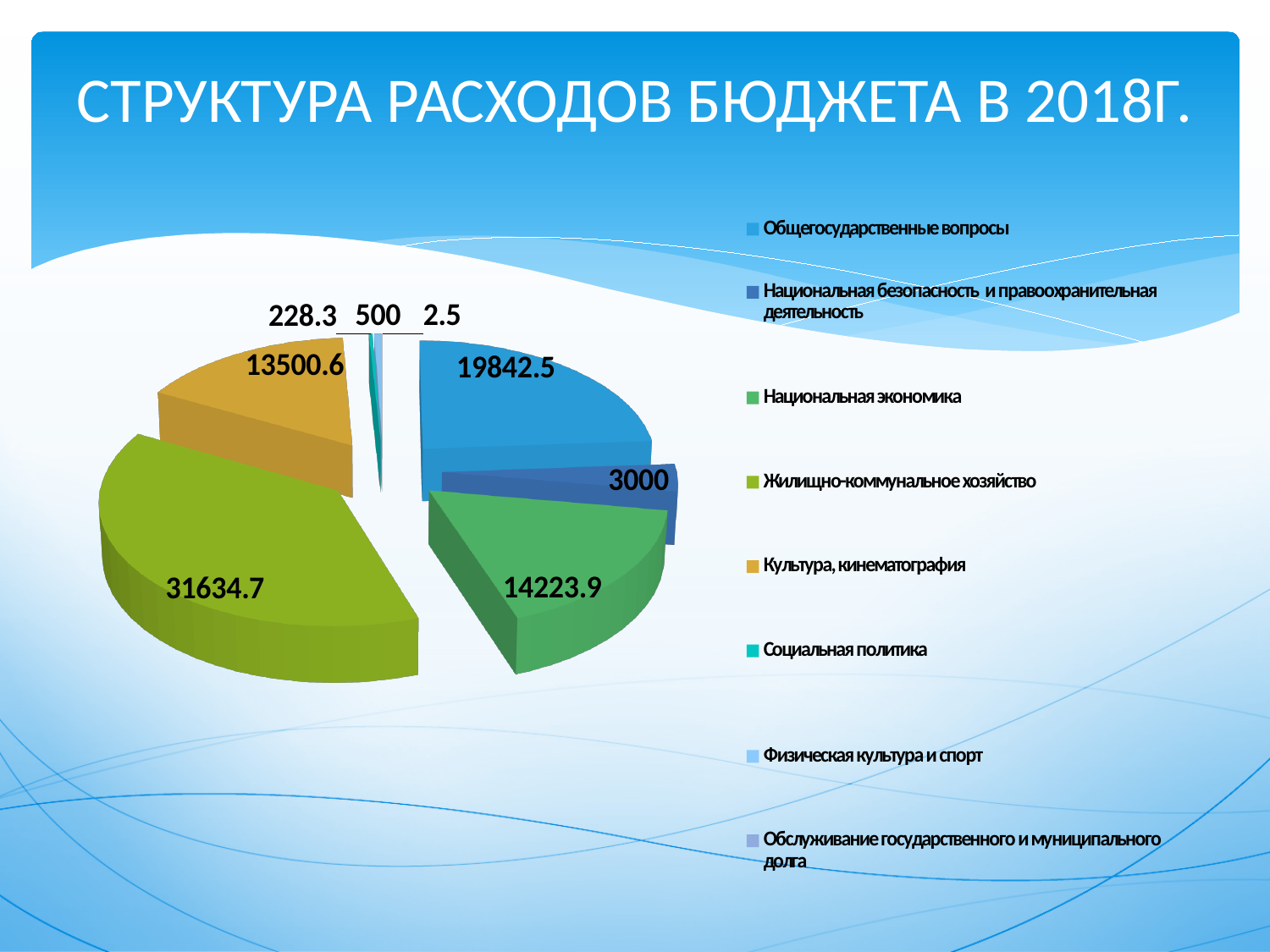
What is the title of the chart on the slide? СТРУКТУРА РАСХОДОВ БЮДЖЕТА В 2018Г. What type of chart is shown on the slide? Pie chart What is the difference between the values for Жилищно-коммунальное хозяйство and Общегосударственные вопросы? 11792.2 Which category has the largest slice of the pie? Жилищно-коммунальное хозяйство What is the value for Национальная безопасность и правоохранительная деятельность? 3000 What is the value for Национальная экономика? 14223.9 Which is larger: the value for Национальная экономика or the value for Культура, кинематография? Национальная экономика What is the value for Культура, кинематография? 13500.6 What is the value for Жилищно-коммунальное хозяйство? 31634.7 What is the value for Общегосударственные вопросы? 19842.5 Which category has the smallest value in the pie chart? Обслуживание государственного и муниципального долга How many categories does the legend of the pie chart list? 8